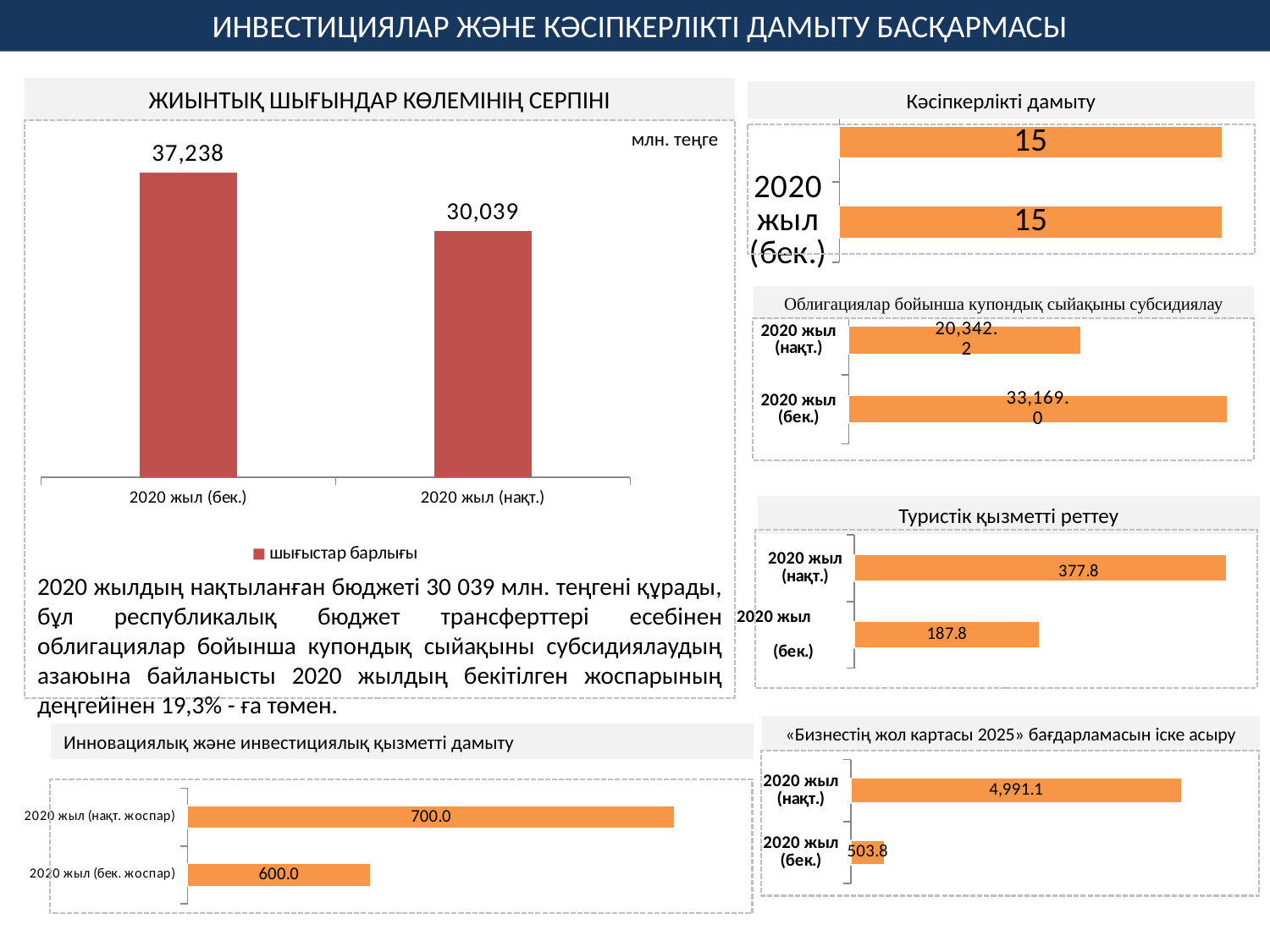
In the chart titled "Облигациялар бойынша купондық сыйақыны субсидиялау", what is the value for 2020 жыл (бек.)? 33,169.0 In the chart titled "ЖИЫНТЫҚ ШЫҒЫНДАР КӨЛЕМІНІҢ СЕРПІНІ", what kind of chart is shown? Bar chart In the chart titled "Облигациялар бойынша купондық сыйақыны субсидиялау", which category has the lower value? 2020 жыл (нақт.) In the chart titled "ЖИЫНТЫҚ ШЫҒЫНДАР КӨЛЕМІНІҢ СЕРПІНІ", what series name does the legend show? шығыстар барлығы In the chart titled "Инновациялық және инвестициялық қызметті дамыту", what is the value for 2020 жыл (бек. жоспар)? 600.0 In the chart titled "ЖИЫНТЫҚ ШЫҒЫНДАР КӨЛЕМІНІҢ СЕРПІНІ", what is the value for 2020 жыл (нақт.)? 30,039 In the chart titled "Туристік қызметті реттеу", what is the difference between the 2020 жыл (нақт.) and 2020 жыл (бек.) values? 190.0 In the chart titled "«Бизнестің жол картасы 2025» бағдарламасын іске асыру", which category has the higher value? 2020 жыл (нақт.) In the chart titled "ЖИЫНТЫҚ ШЫҒЫНДАР КӨЛЕМІНІҢ СЕРПІНІ", what is the difference between the 2020 жыл (бек.) and 2020 жыл (нақт.) values? 7,199 In the chart titled "Туристік қызметті реттеу", what is the value for 2020 жыл (нақт.)? 377.8 In the chart titled "ЖИЫНТЫҚ ШЫҒЫНДАР КӨЛЕМІНІҢ СЕРПІНІ", what is the value for 2020 жыл (бек.)? 37,238 In the chart titled "«Бизнестің жол картасы 2025» бағдарламасын іске асыру", what is the value for 2020 жыл (бек.)? 503.8